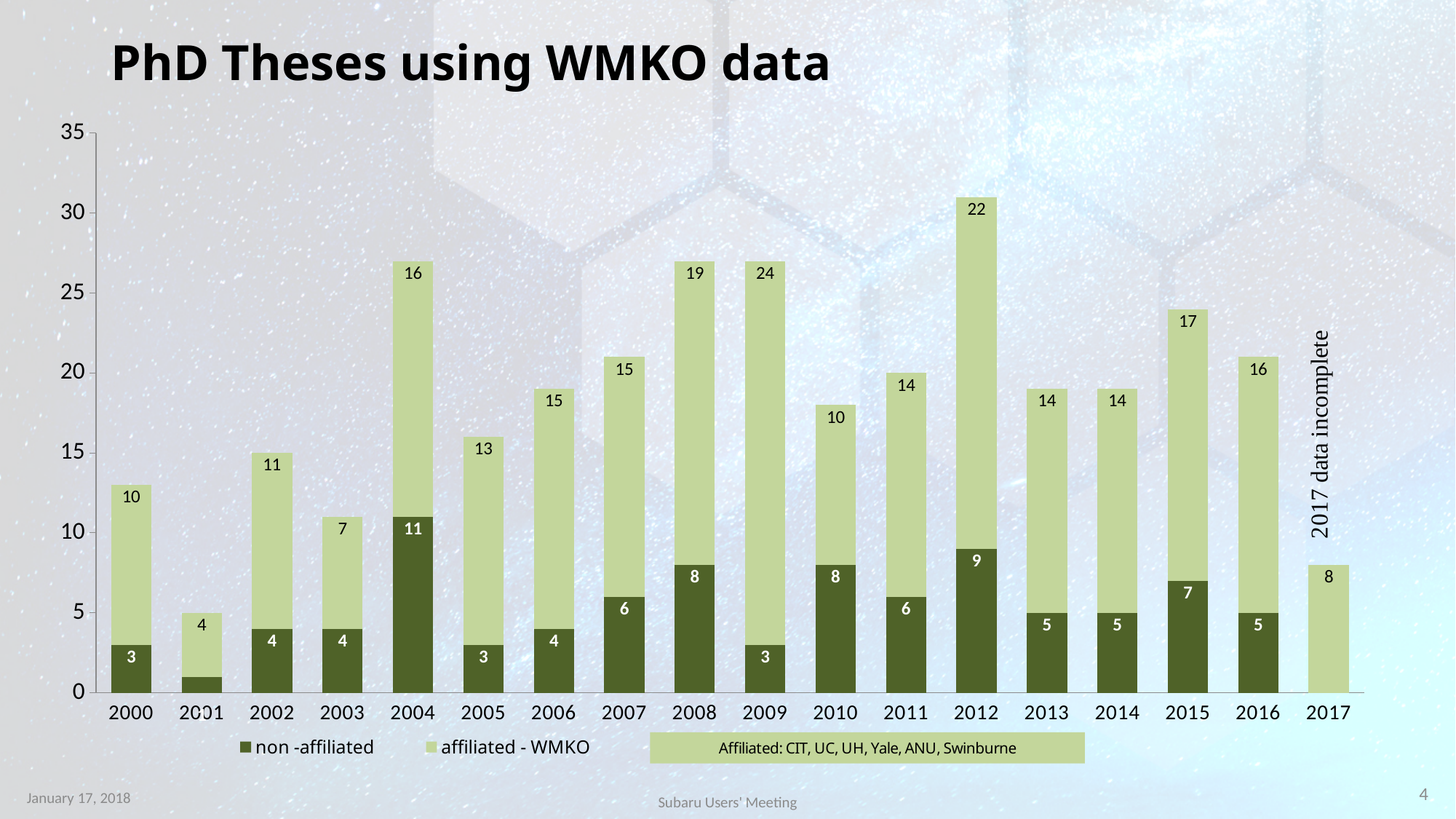
Which year has the highest affiliated - WMKO value? 2009 What is the non-affiliated value for 2004? 11 What note is written beside the 2017 bar? 2017 data incomplete What is the affiliated - WMKO value for 2017? 8 What is the total of the stacked bar for 2012? 31 Which is larger, the non-affiliated value for 2008 or for 2013? 2008 What is the difference between the affiliated - WMKO values for 2012 and 2010? 12 How many years are shown on the x axis? 18 What is the affiliated - WMKO value for 2009? 24 How many series does the legend list? 2 Which year has the highest non-affiliated value? 2004 What type of chart is shown on the slide? stacked bar chart